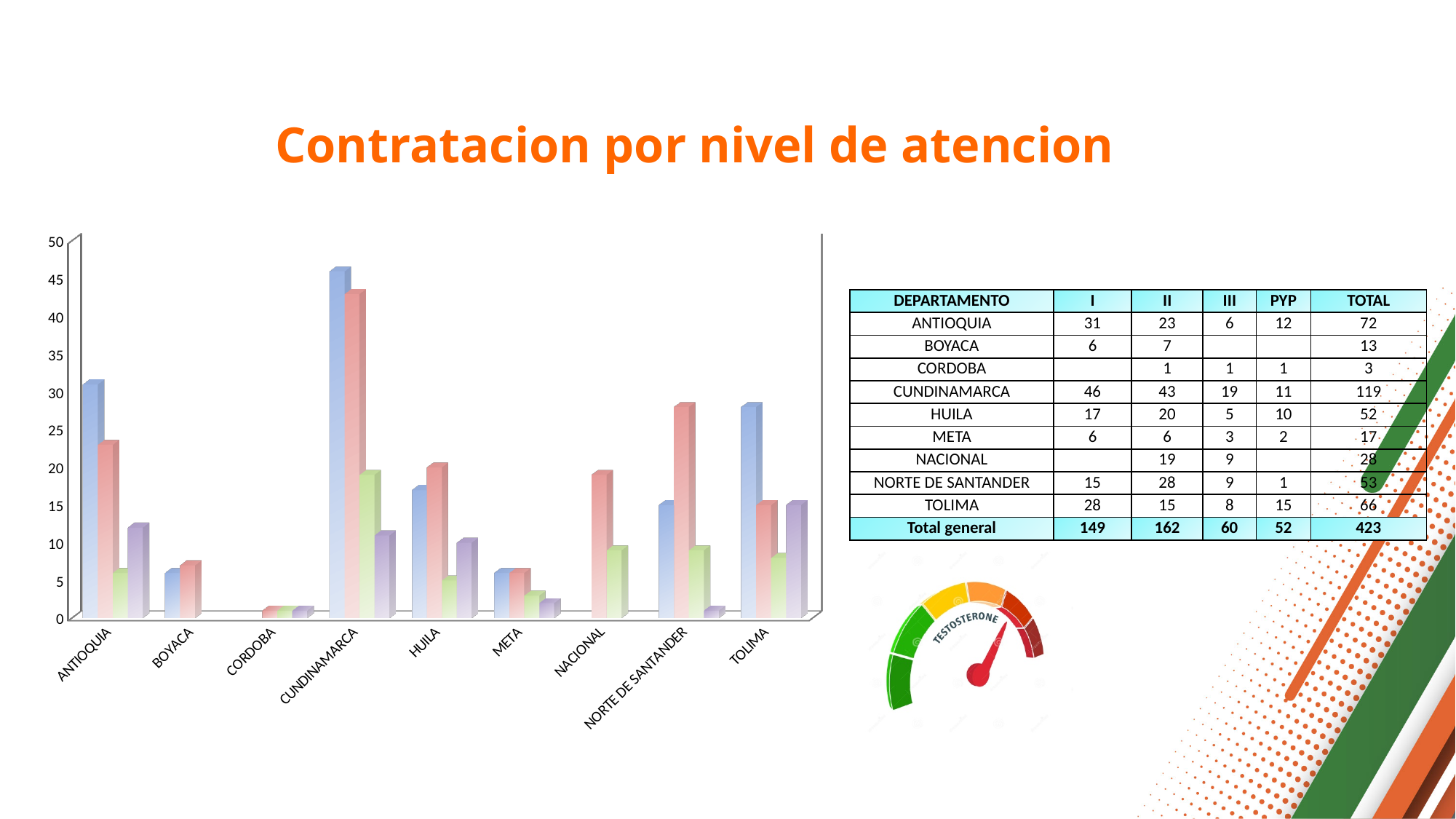
Is the tallest bar for NORTE DE SANTANDER greater or less than 20? greater Is the tallest bar for CUNDINAMARCA greater or less than 40? greater Which category has the smallest bars in the chart? CORDOBA Which category has a taller tallest bar, ANTIOQUIA or BOYACA? ANTIOQUIA What is the highest value shown on the chart's vertical axis? 50 How many categories (departments) are shown on the x axis of the chart? 9 Which category has a taller tallest bar, CUNDINAMARCA or TOLIMA? CUNDINAMARCA Which category has the tallest bar in the chart? CUNDINAMARCA Is the tallest bar for META greater or less than 10? less What is the title of the slide above the chart? Contratacion por nivel de atencion What kind of chart is shown on the slide? bar chart